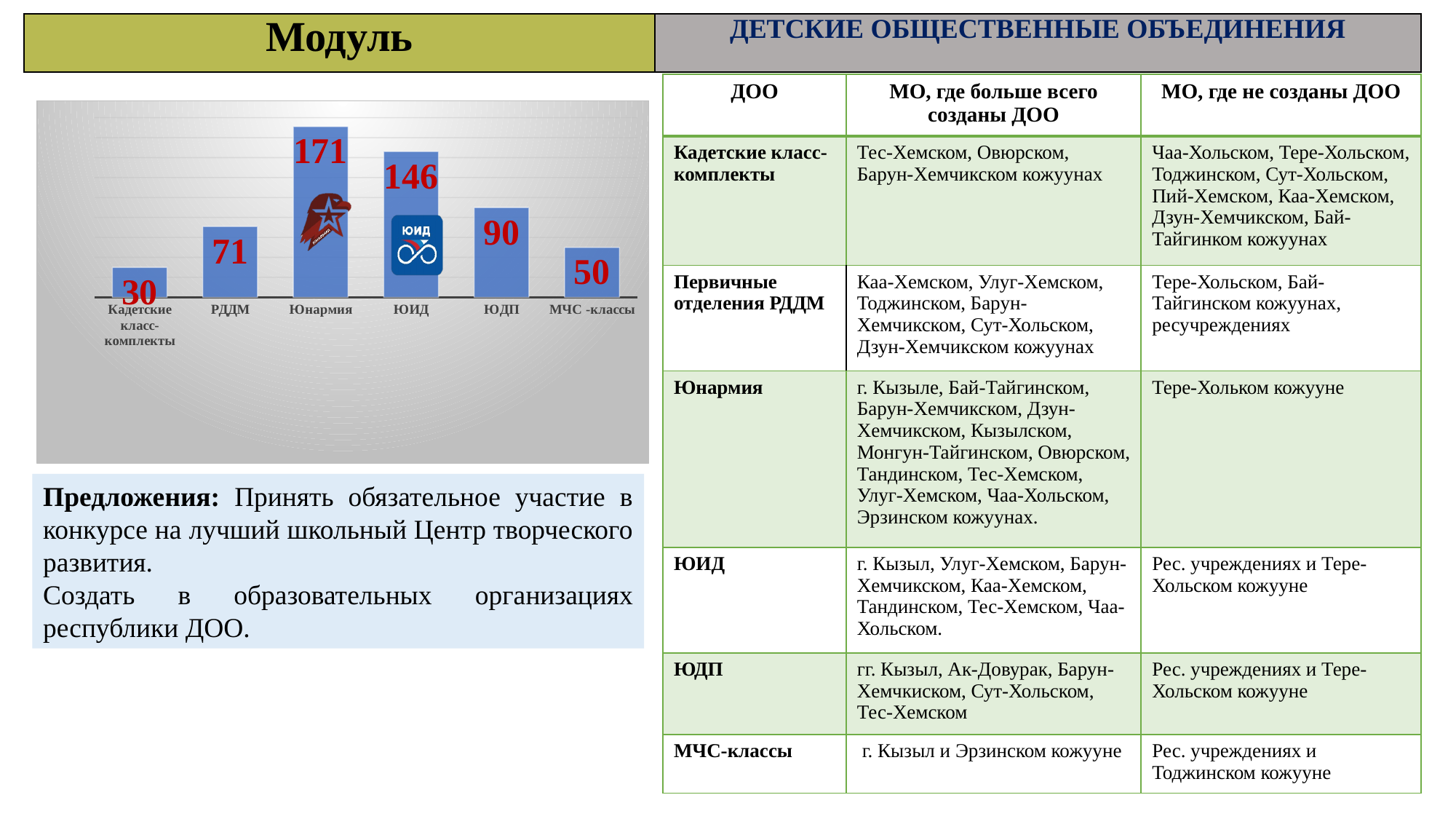
Which category has the highest value? Юнармия How many categories are shown in the chart? 6 What is the value for МЧС-классы? 50 Which category has the lowest value? Кадетские класс-комплекты What is the difference between the values for ЮДП and МЧС-классы? 40 What is the value for ЮИД? 146 What is the value for Юнармия? 171 What kind of chart is shown on the slide? Bar chart What is the value for РДДМ? 71 Which is larger, the value for РДДМ or the value for ЮДП? ЮДП What is the value for Кадетские класс-комплекты? 30 What is the difference between the values for Юнармия and ЮИД? 25